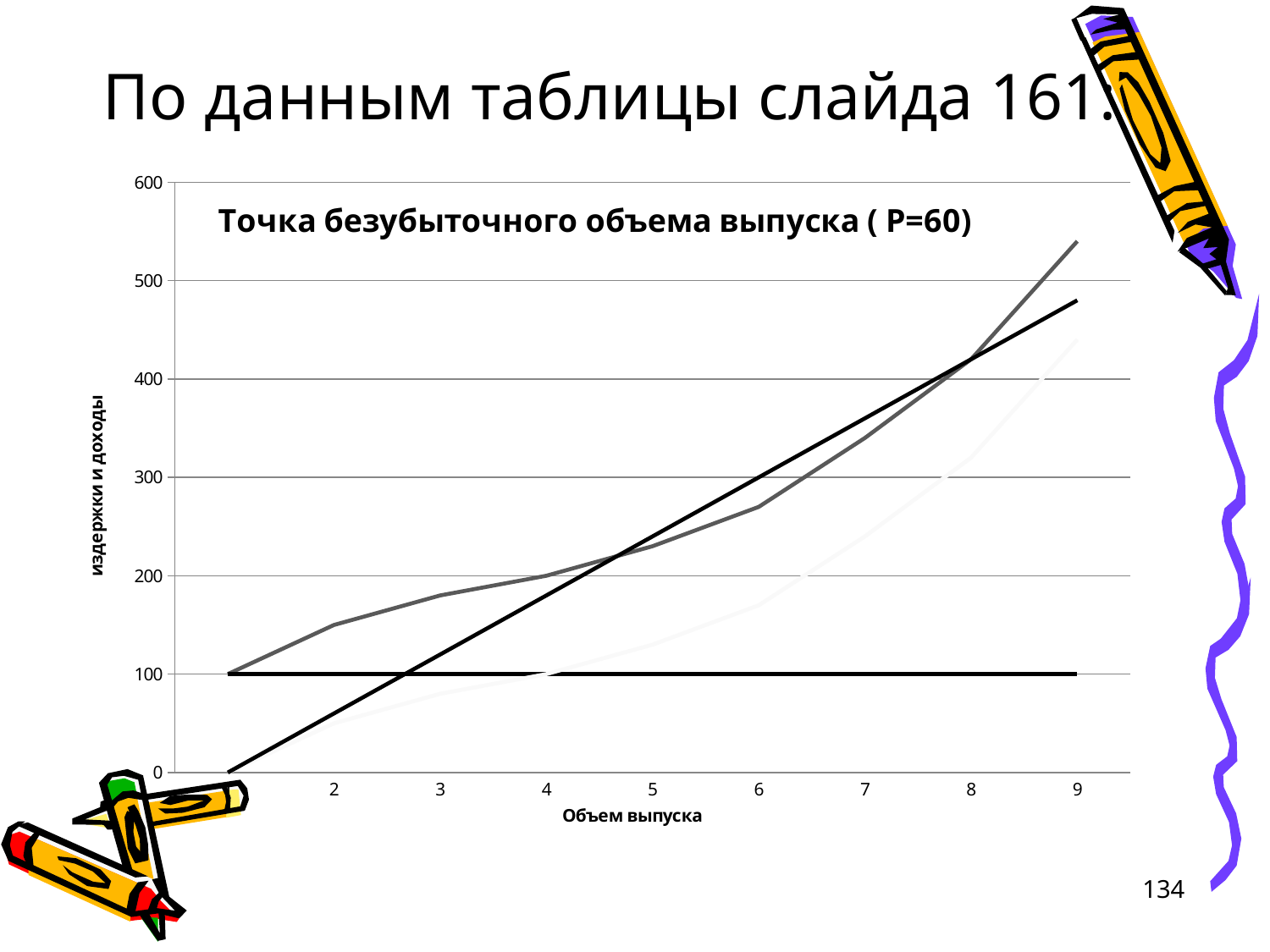
Is the value of the straight rising black line at Объем выпуска 2 greater or less than 100? less At what value does the horizontal line on the chart stay across the whole x axis? 100 What kind of chart is shown on the slide? line chart Is the value of the gray curved line at Объем выпуска 7 greater or less than 300? greater What is the title of the chart? Точка безубыточного объема выпуска ( Р=60) Is the value of the gray curved line at Объем выпуска 2 greater or less than 100? greater What is the label of the x axis of the chart? Объем выпуска How many numbered tick labels are shown on the x axis of the chart? 8 At Объем выпуска 9, which is higher: the gray curved line or the straight rising black line? the gray curved line Does the straight black line starting at 0 rise or fall as Объем выпуска increases? rises